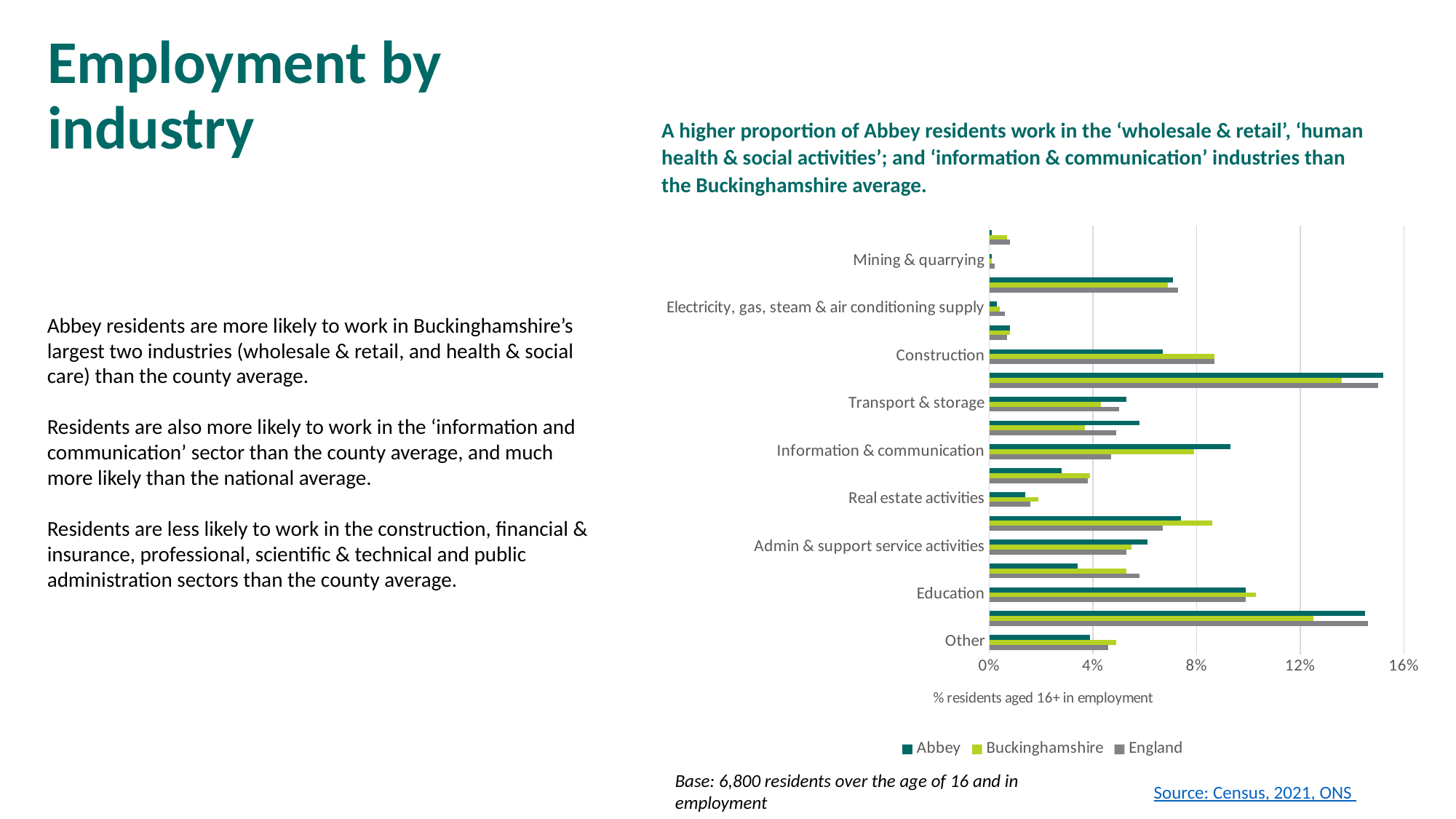
What kind of chart is shown on the slide? bar chart Is the England value for Mining & quarrying greater or less than 4%? less Is the Abbey value for Information & communication greater or less than 8%? greater For Information & communication, which is larger: the Abbey value or the England value? Abbey Is the Abbey value for Education greater or less than 8%? greater For Construction, which is larger: the Abbey value or the Buckinghamshire value? Buckinghamshire What is the label on the chart's horizontal axis? % residents aged 16+ in employment For Information & communication, which of the three series has the highest value? Abbey What are the three series listed in the chart legend? Abbey, Buckinghamshire, England How many series does the chart legend list? 3